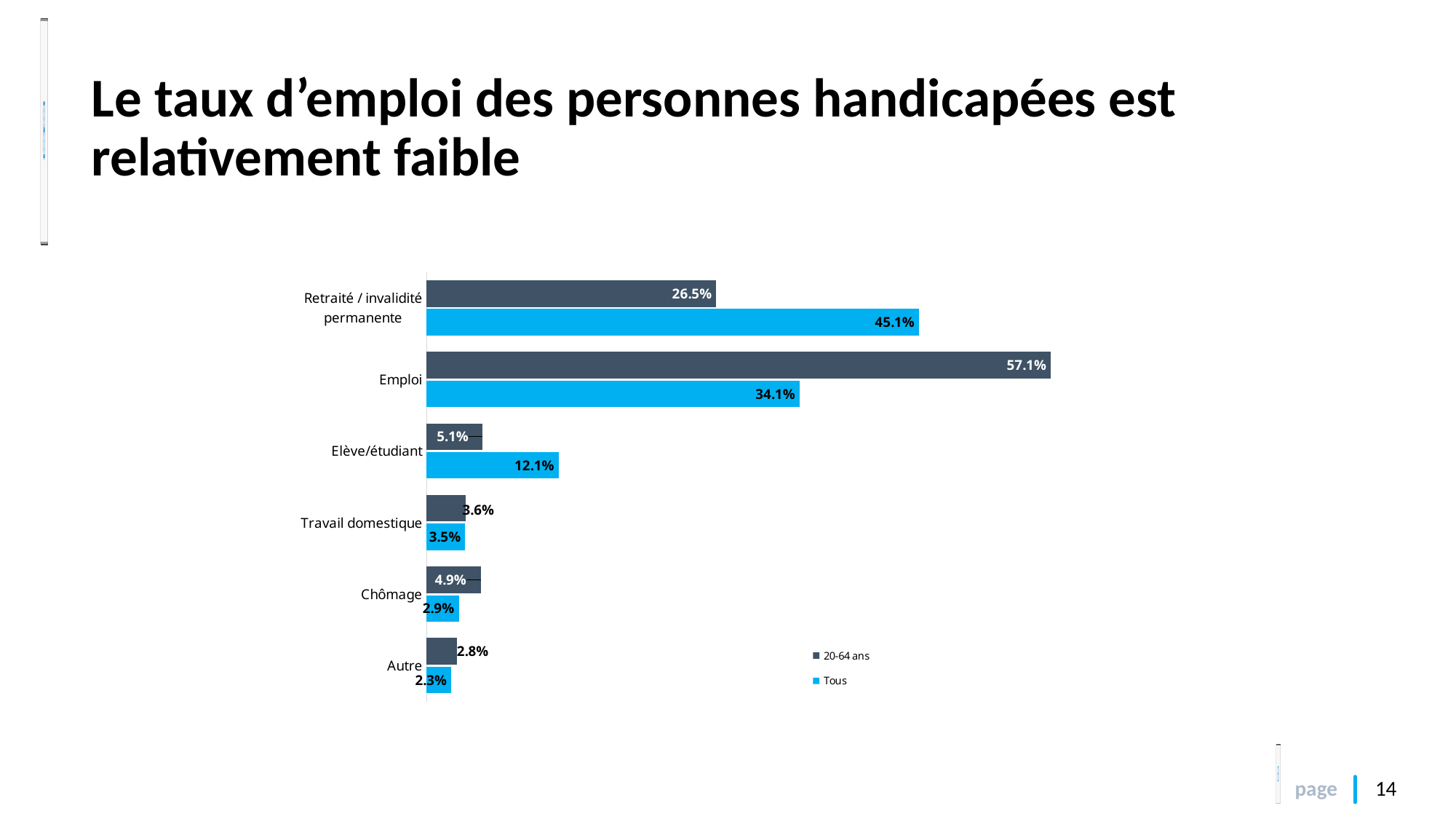
Which category has the lowest value in the Tous series? Autre What is the value for Emploi in the 20-64 ans series? 57.1% What is the value for Chômage in the 20-64 ans series? 4.9% What is the value for Elève/étudiant in the Tous series? 12.1% Which is larger for Retraité / invalidité permanente: the 20-64 ans value or the Tous value? Tous Which category has the highest value in the 20-64 ans series? Emploi What kind of chart is shown on the slide? Bar chart What is the value for Retraité / invalidité permanente in the Tous series? 45.1% Which series is shown in light blue? Tous How many series does the legend list? 2 What is the difference between the 20-64 ans and Tous values for Emploi? 23.0% How many categories are shown on the chart? 6